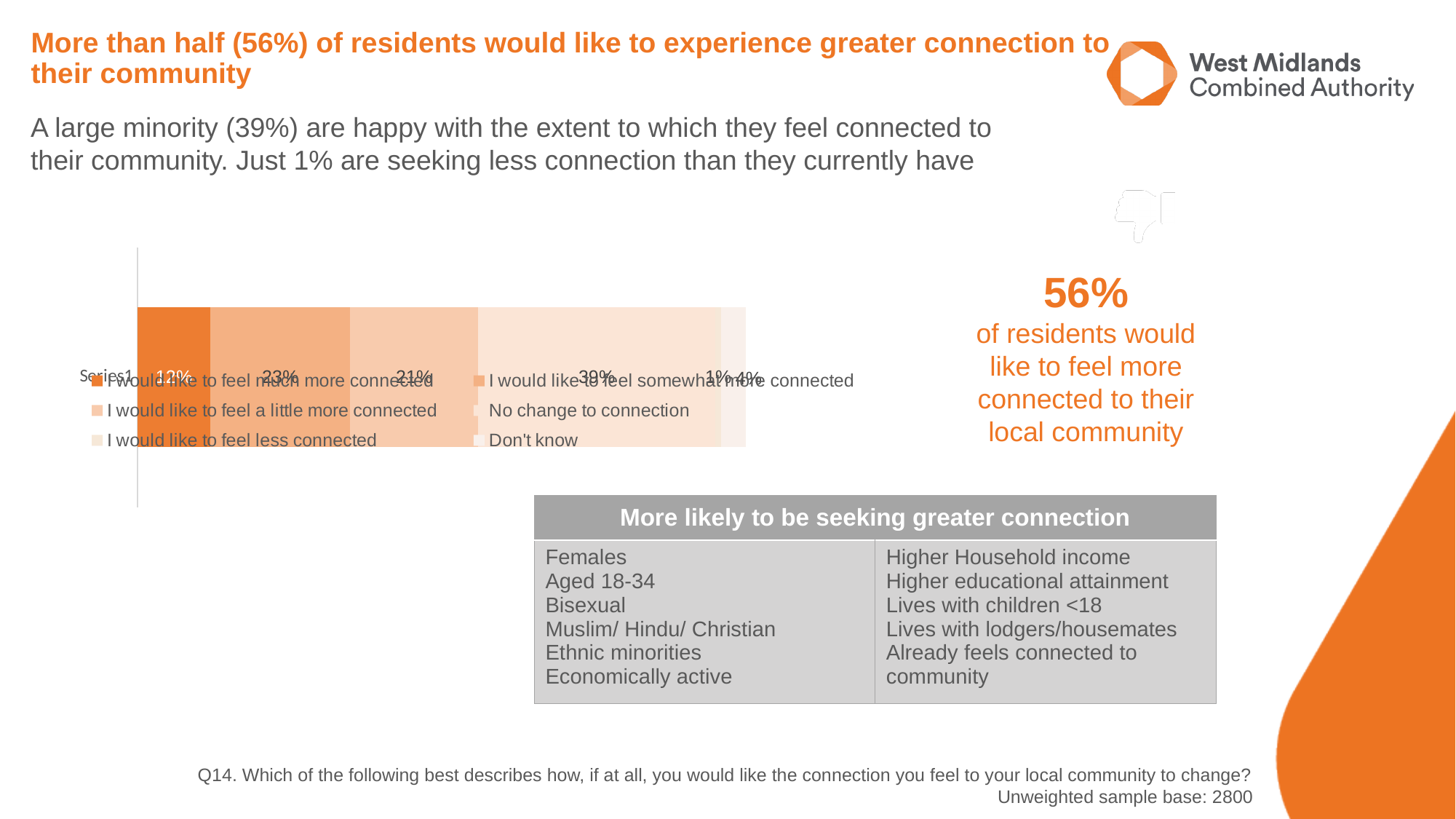
How many series does the chart legend list? 6 What is the difference between the 'No change to connection' share and the 'I would like to feel much more connected' share? 27% What percentage of residents said 'I would like to feel a little more connected'? 21% What percentage of residents said 'I would like to feel much more connected'? 12% What percentage of residents answered 'Don't know'? 4% What kind of chart is shown on the slide? Stacked bar chart What percentage of residents said 'I would like to feel somewhat more connected'? 23% What percentage of residents said 'I would like to feel less connected'? 1% Which response has the smallest share in the bar? I would like to feel less connected What percentage of residents said 'No change to connection'? 39% Which is larger: 'I would like to feel somewhat more connected' or 'I would like to feel a little more connected'? I would like to feel somewhat more connected Which response has the largest share in the bar? No change to connection